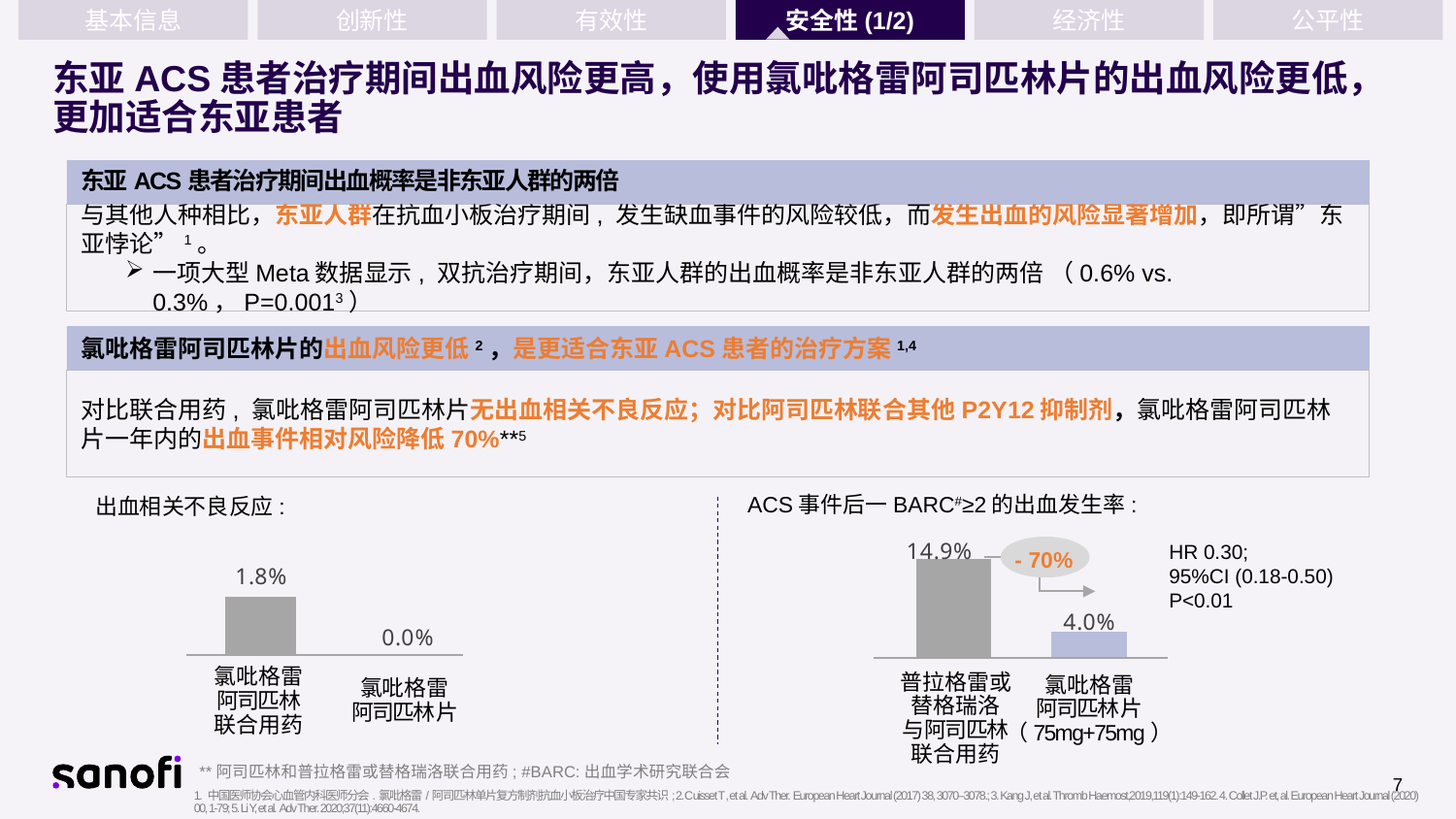
In the right chart (ACS 事件后一 BARC≥2 的出血发生率), what relative reduction is annotated between the two bars? -70% In the right chart (ACS 事件后一 BARC≥2 的出血发生率), what hazard ratio is shown next to the bars? HR 0.30 In the right chart (ACS 事件后一 BARC≥2 的出血发生率), what is the value for 氯吡格雷阿司匹林片（75mg+75mg）? 4.0% In the right chart (ACS 事件后一 BARC≥2 的出血发生率), which category has the lower value? 氯吡格雷阿司匹林片（75mg+75mg） In the right chart (ACS 事件后一 BARC≥2 的出血发生率), what is the difference between the two bars? 10.9% In the right chart (ACS 事件后一 BARC≥2 的出血发生率), what is the value for 普拉格雷或替格瑞洛与阿司匹林联合用药? 14.9% In the left chart (出血相关不良反应), how many bars are shown? 2 In the left chart (出血相关不良反应), which category has the higher value? 氯吡格雷阿司匹林联合用药 In the left chart (出血相关不良反应), what is the value for 氯吡格雷阿司匹林片? 0.0% What type of chart is the left chart (出血相关不良反应)? bar chart In the left chart (出血相关不良反应), what is the value for 氯吡格雷阿司匹林联合用药? 1.8% In the left chart (出血相关不良反应), what is the difference between the two bars? 1.8%